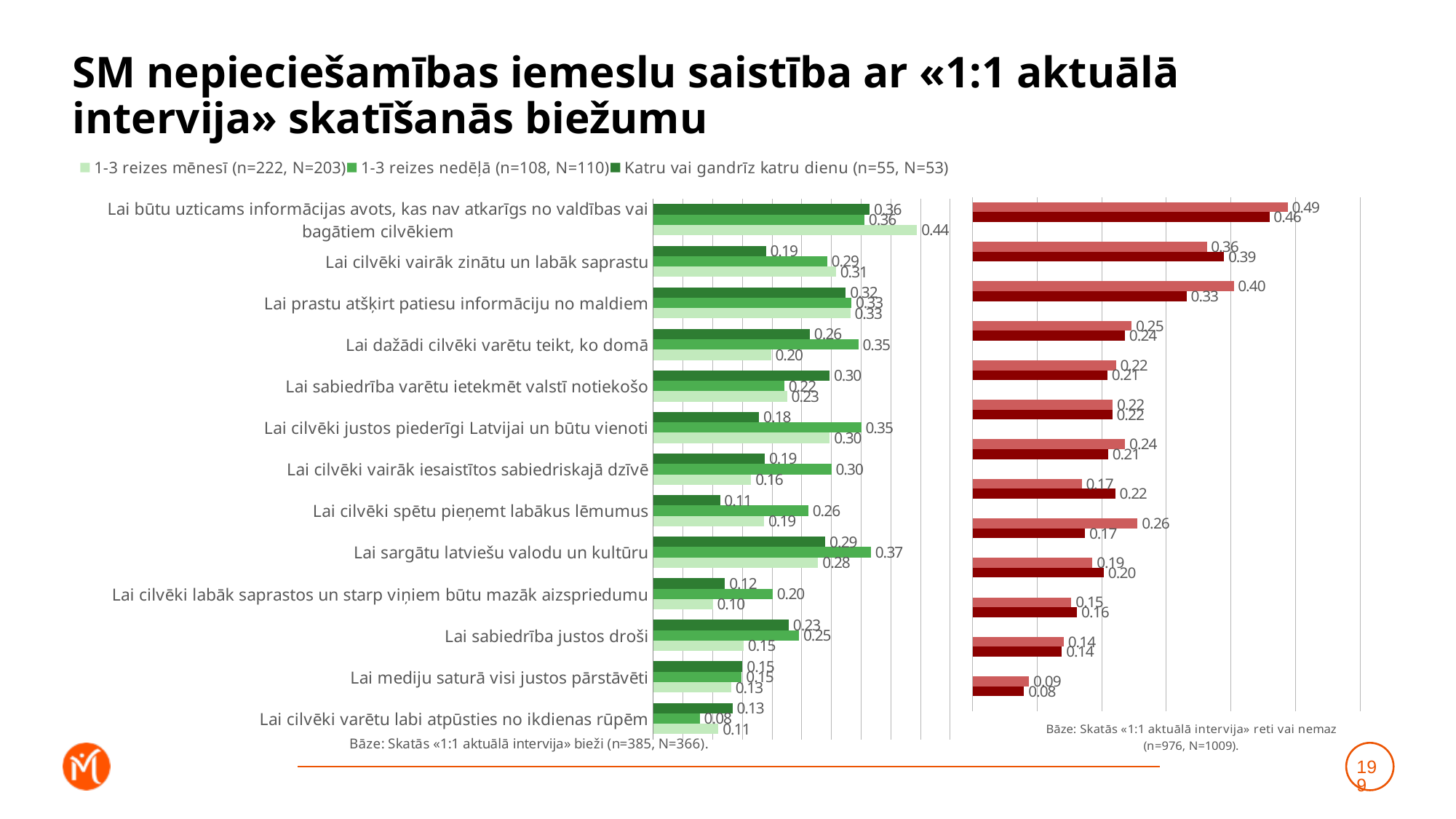
How many categories (reasons) are plotted in the green chart on the left? 13 In the green chart on the left, for 'Lai dažādi cilvēki varētu teikt, ko domā', how much larger is the '1-3 reizes nedēļā' value than the '1-3 reizes mēnesī' value? 0.15 What kind of chart is the green chart on the left of the slide? bar chart In the green chart on the left, what is the value of 'Katru vai gandrīz katru dienu' for 'Lai sabiedrība varētu ietekmēt valstī notiekošo'? 0.30 How many series does the legend above the green chart list? 3 In the green chart on the left, what is the value of '1-3 reizes nedēļā' for 'Lai sargātu latviešu valodu un kultūru'? 0.37 In the red chart on the right, what is the value of the lighter red (upper) bar for 'Lai būtu uzticams informācijas avots, kas nav atkarīgs no valdības vai bagātiem cilvēkiem'? 0.49 In the green chart on the left, for 'Lai cilvēki justos piederīgi Latvijai un būtu vienoti', which is larger: the '1-3 reizes nedēļā' value or the 'Katru vai gandrīz katru dienu' value? 1-3 reizes nedēļā In the red chart on the right, which category has the lowest dark red (lower) bar value? Lai cilvēki varētu labi atpūsties no ikdienas rūpēm In the green chart on the left, which category has the lowest '1-3 reizes nedēļā' value? Lai cilvēki varētu labi atpūsties no ikdienas rūpēm In the green chart on the left, what is the value of '1-3 reizes mēnesī' for 'Lai būtu uzticams informācijas avots, kas nav atkarīgs no valdības vai bagātiem cilvēkiem'? 0.44 In the green chart on the left, which category has the highest '1-3 reizes mēnesī' value? Lai būtu uzticams informācijas avots, kas nav atkarīgs no valdības vai bagātiem cilvēkiem